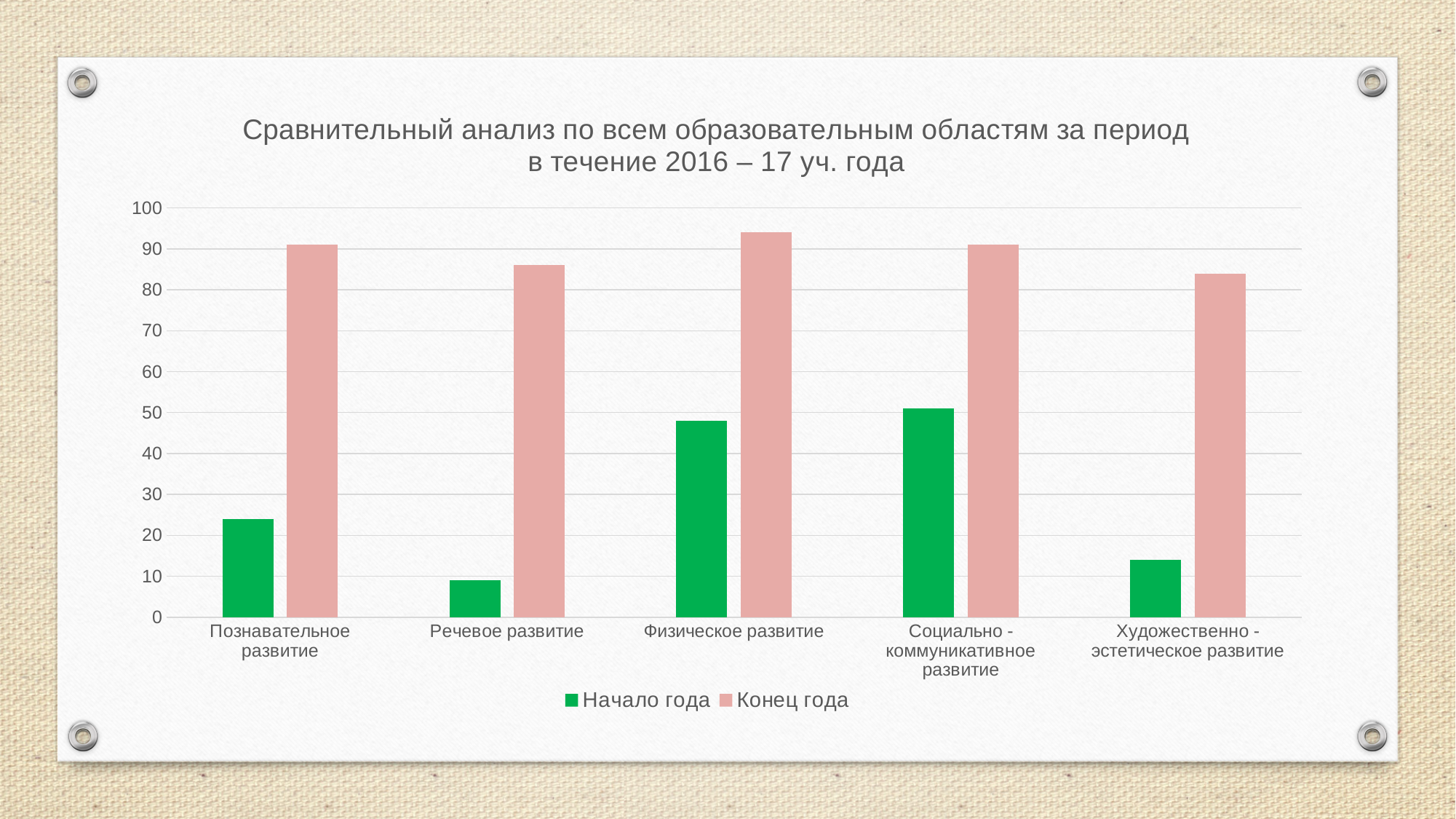
What kind of chart is shown on the slide? bar chart Which category has the highest value for Конец года? Физическое развитие Is the value for Начало года in Речевое развитие greater or less than 20? less Which series is shown in green? Начало года Is the value for Начало года in Физическое развитие greater or less than 40? greater How many series does the legend list? 2 Is the value for Начало года in Художественно-эстетическое развитие greater or less than 20? less Which is larger: the Начало года value for Познавательное развитие or for Художественно-эстетическое развитие? Познавательное развитие Which category has the lowest value for Начало года? Речевое развитие How many categories are shown on the x axis? 5